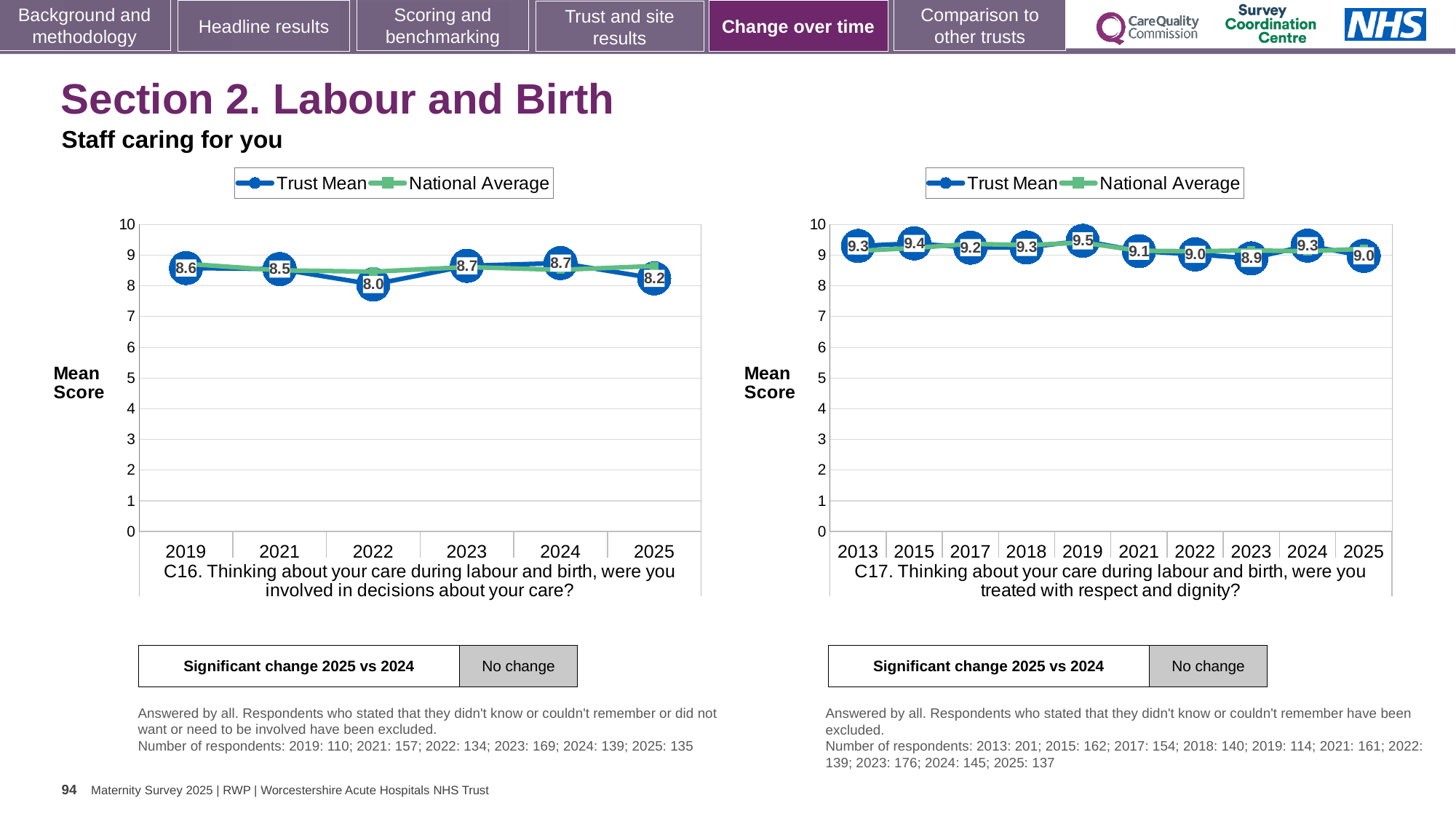
What type of chart is the C16 chart on the left? Line chart In the C17 chart on the right, what is the Trust Mean score for 2023? 8.9 In the C16 chart on the left, what is the difference between the Trust Mean scores for 2024 and 2025? 0.5 In the C16 chart on the left, what is the Trust Mean score for 2022? 8.0 In the C16 chart on the left, how many years are plotted on the x axis? 6 In the C16 chart on the left, which year has the lowest Trust Mean score? 2022 In the C17 chart on the right, how many series does the legend list? 2 In the C17 chart on the right, which year has the lowest Trust Mean score? 2023 In the C17 chart on the right, what is the Trust Mean score for 2019? 9.5 In the C17 chart on the right, is the Trust Mean score higher in 2015 or in 2022? 2015 In the C16 chart on the left, what is the Trust Mean score for 2025? 8.2 In the C17 chart on the right, which year has the highest Trust Mean score? 2019